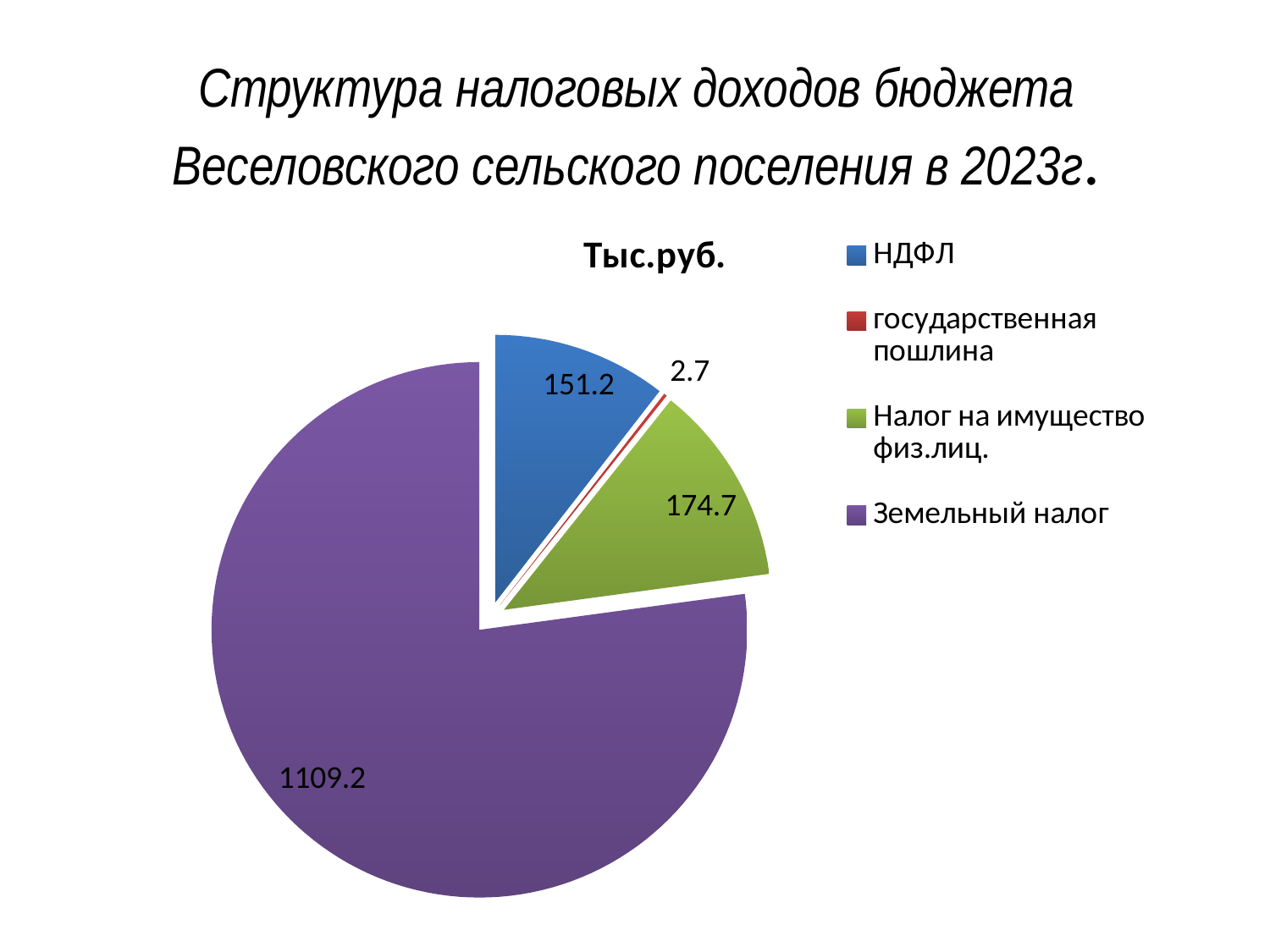
What is the value for государственная пошлина? 2.7 What type of chart is shown on the slide? pie chart Which category has the largest slice of the pie? Земельный налог What is the difference between the values for Налог на имущество физ.лиц. and НДФЛ? 23.5 What is the title shown above the pie chart? Тыс.руб. What is the value for Земельный налог? 1109.2 What share of the pie does Земельный налог represent? 77.1% What is the value for Налог на имущество физ.лиц.? 174.7 How many slices does the pie chart have? 4 Which is larger, the value for НДФЛ or the value for Налог на имущество физ.лиц.? Налог на имущество физ.лиц. What is the value for НДФЛ? 151.2 Which category has the smallest slice of the pie? государственная пошлина